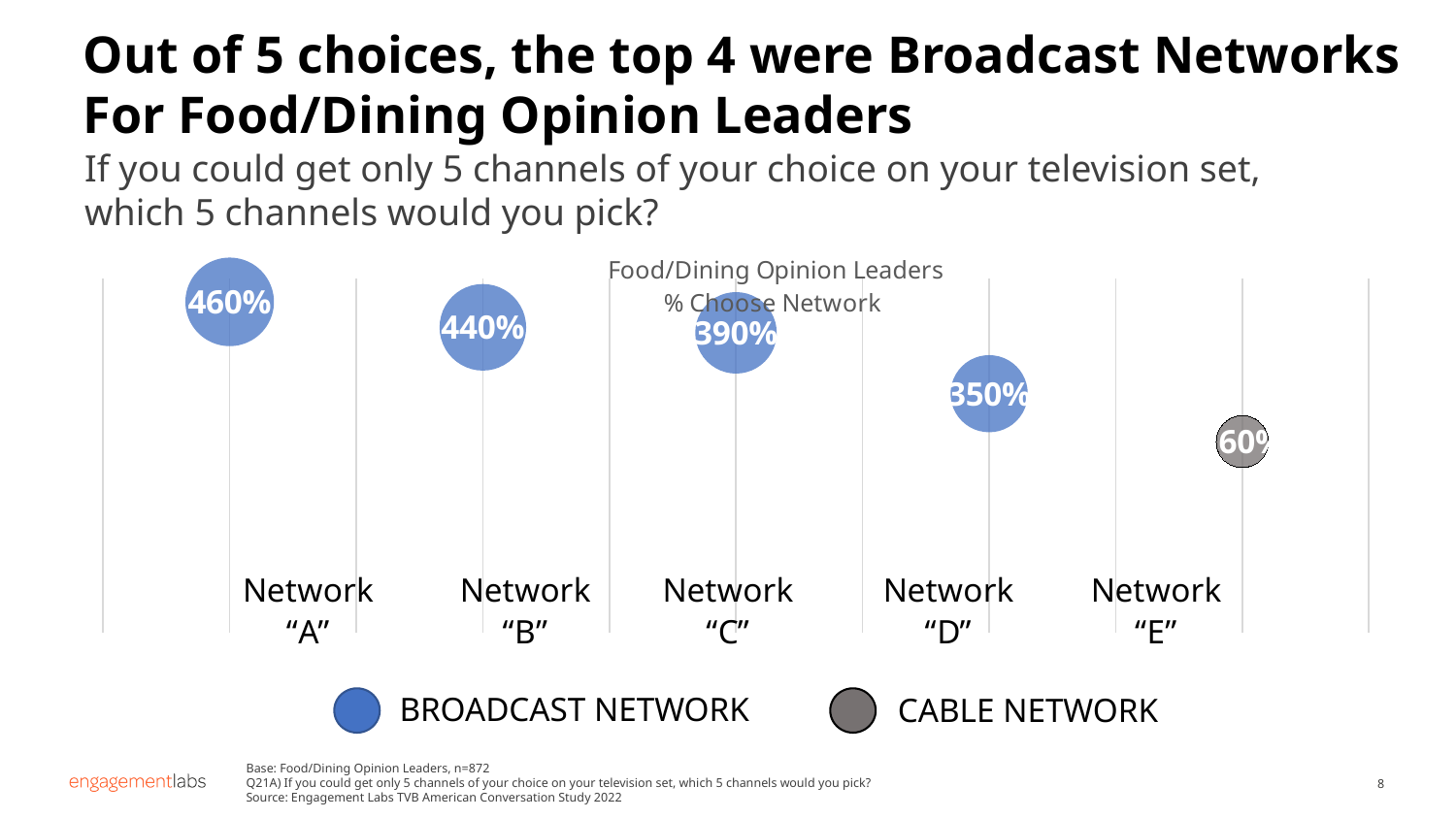
Which network has the lowest value? Network "E" Which network has the highest value? Network "A" Do the values rise or fall from Network "A" to Network "E"? fall Which is larger, the value for Network "C" or Network "D"? Network "C" What is the value for Network "C"? 390% Which network is shown as a Cable Network in the chart? Network "E" What is the value for Network "B"? 440% What is the difference between the values for Network "B" and Network "C"? 50% What is the difference between the values for Network "A" and Network "D"? 110% What is the value for Network "D"? 350% How many networks are shown in the chart? 5 What is the value for Network "A"? 460%